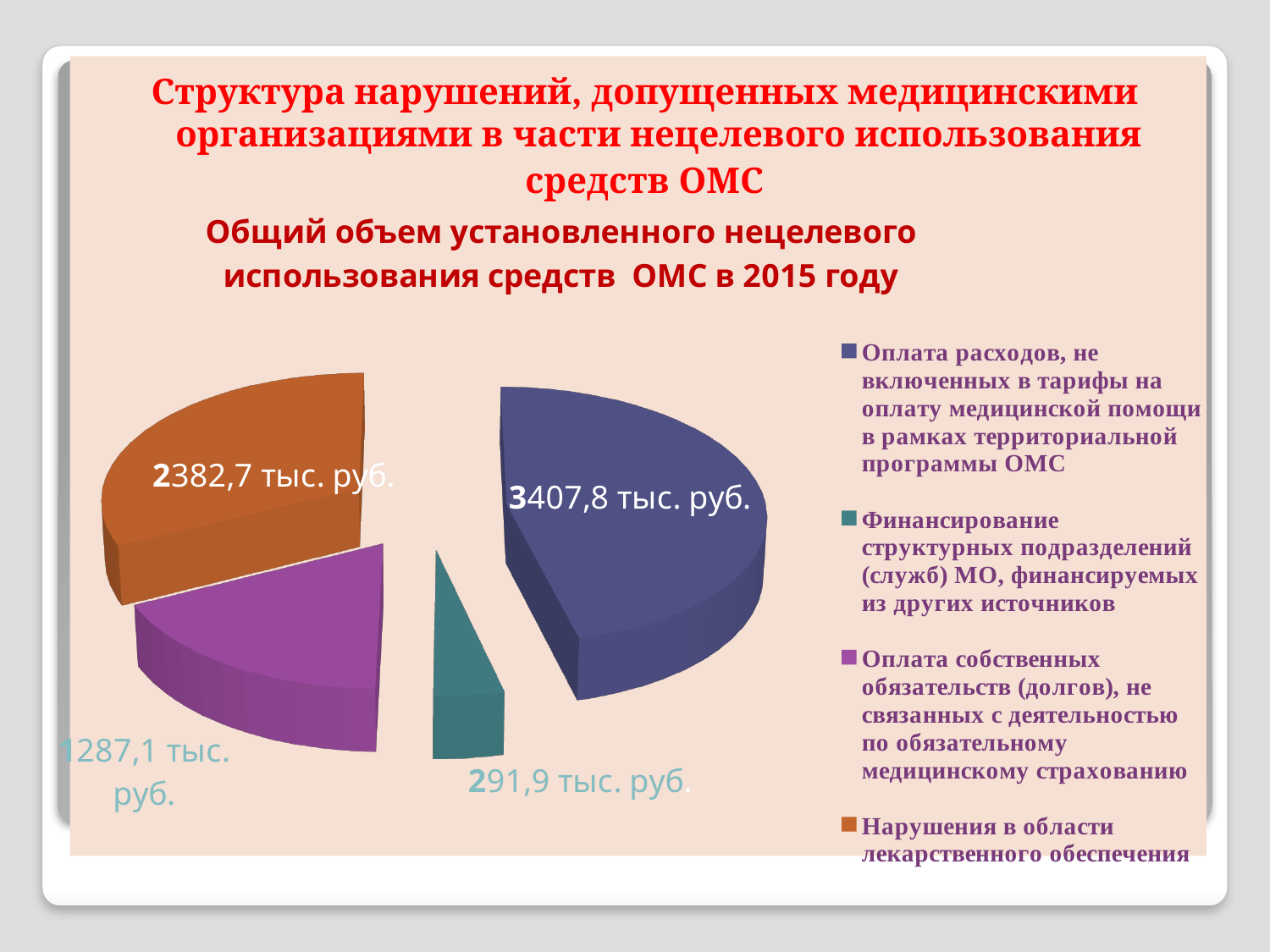
What is the value of the slice for «Оплата расходов, не включенных в тарифы на оплату медицинской помощи в рамках территориальной программы ОМС»? 3407,8 тыс. руб. What is the value of the slice for «Оплата собственных обязательств (долгов), не связанных с деятельностью по обязательному медицинскому страхованию»? 1287,1 тыс. руб. What kind of chart is shown on the slide? Pie chart How many entries does the legend of the pie chart list? 4 How many slices does the pie chart have? 4 What is the difference between the largest slice (3407,8 тыс. руб.) and the slice for «Нарушения в области лекарственного обеспечения» (2382,7 тыс. руб.)? 1025,1 тыс. руб. Which is larger: the slice for «Оплата собственных обязательств (долгов)» or the slice for «Финансирование структурных подразделений (служб) МО»? Оплата собственных обязательств (долгов) What is the value of the slice for «Нарушения в области лекарственного обеспечения»? 2382,7 тыс. руб. What colour is the slice for «Нарушения в области лекарственного обеспечения»? Orange Which category has the smallest slice in the pie chart? Финансирование структурных подразделений (служб) МО, финансируемых из других источников Which category has the largest slice in the pie chart? Оплата расходов, не включенных в тарифы на оплату медицинской помощи в рамках территориальной программы ОМС What is the value of the slice for «Финансирование структурных подразделений (служб) МО, финансируемых из других источников»? 291,9 тыс. руб.